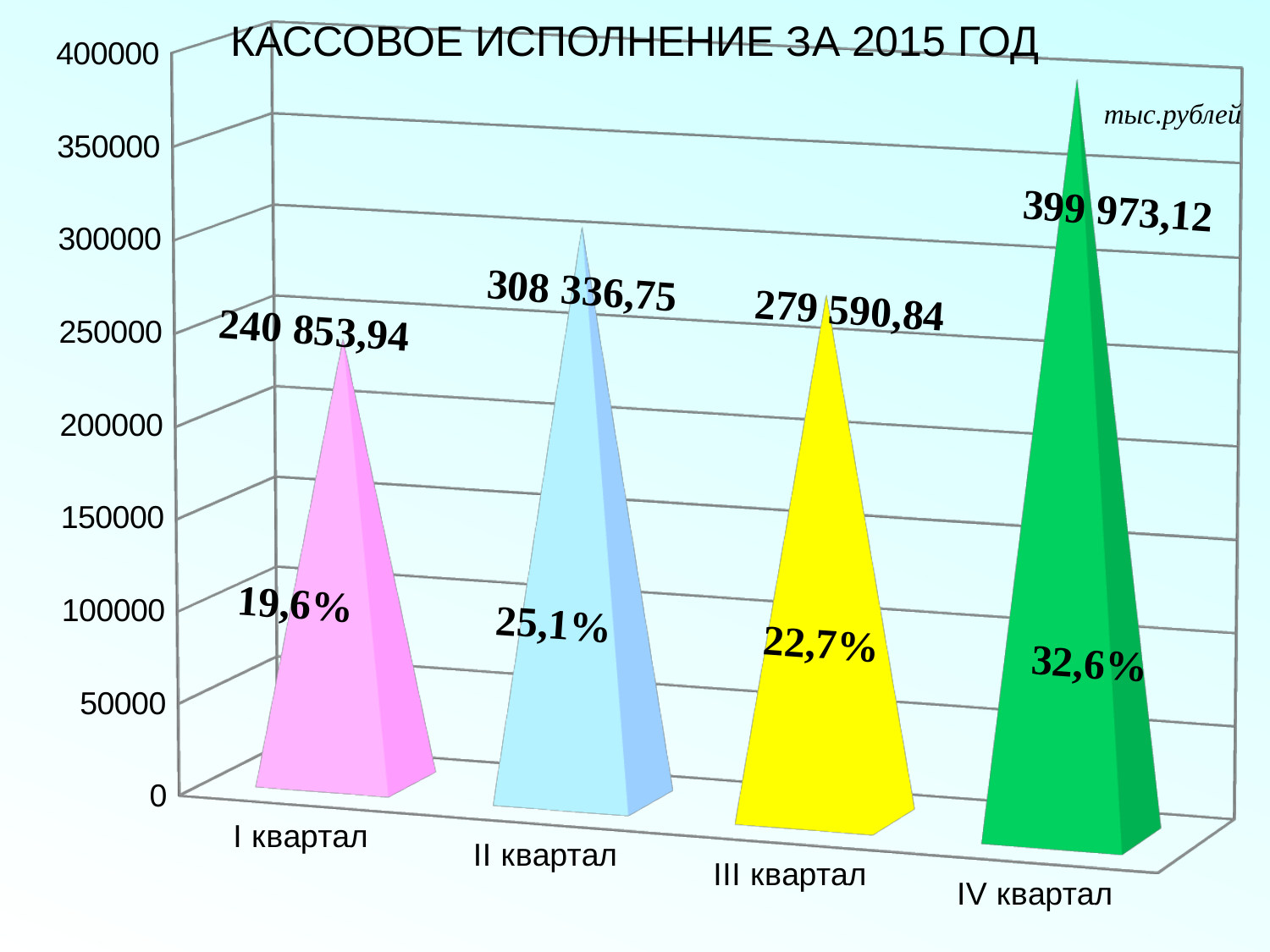
Which quarter has the highest value? IV квартал What is the value for IV квартал? 399 973,12 What unit is indicated for the values on the chart? тыс.рублей What percentage is shown for II квартал? 25,1% Is the value for II квартал greater or less than 300000? greater What is the value for III квартал? 279 590,84 Which quarter has the lowest value? I квартал What is the difference between the values for IV квартал and I квартал? 159 119,18 How many quarters are shown on the chart? 4 What is the value for I квартал? 240 853,94 What kind of chart is shown on the slide? bar chart Which is larger, the value for II квартал or III квартал? II квартал